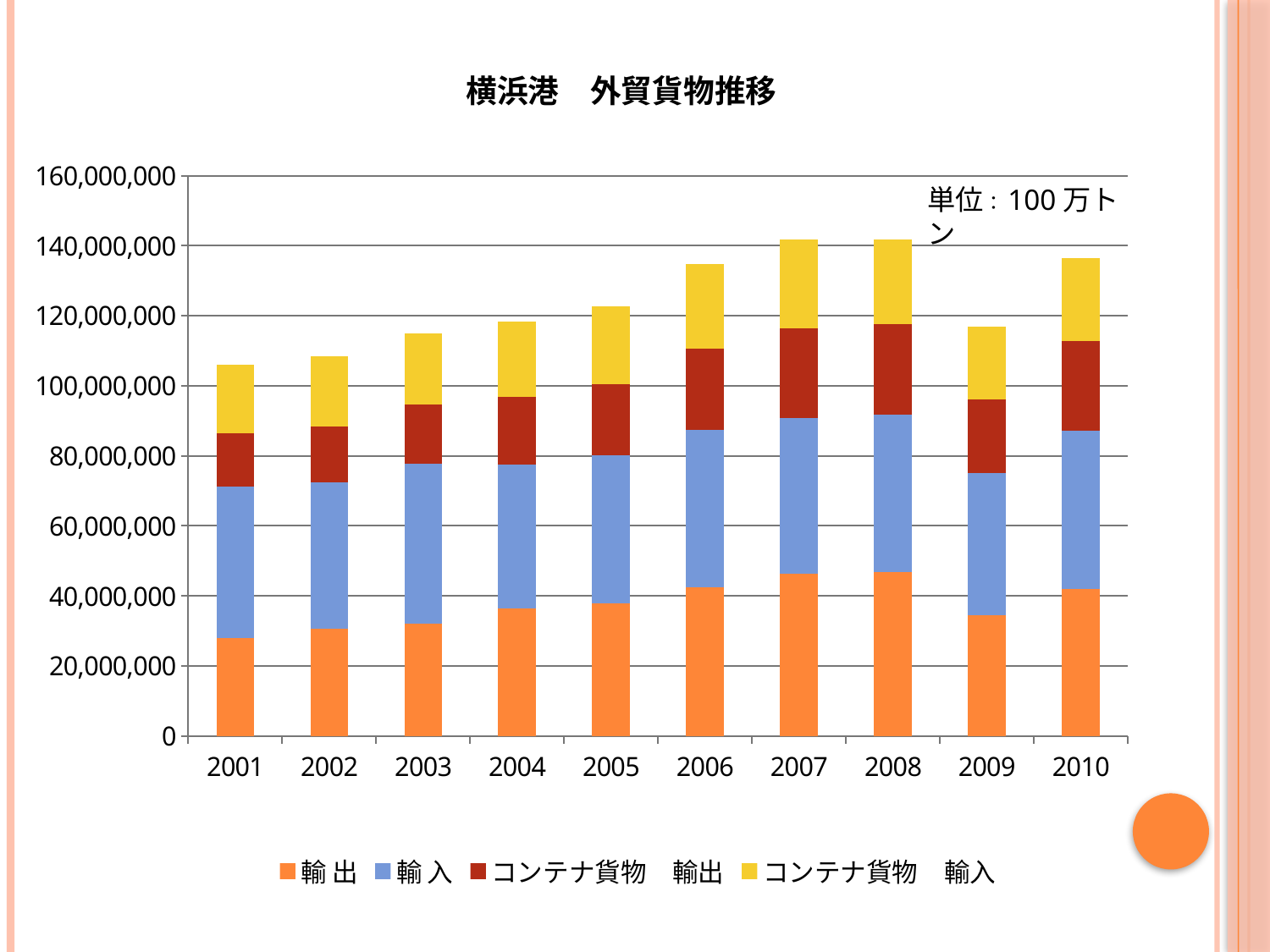
Is the total stacked value for 2001 greater or less than 100,000,000? greater Is the 輸出 value for 2007 greater or less than 40,000,000? greater Is the 輸出 value for 2001 greater or less than 40,000,000? less What is the title of the chart? 横浜港 外貿貨物推移 How many series does the legend list? 4 How many years are shown on the x axis? 10 What kind of chart is shown on the slide? Stacked bar chart Do the total stacked values rise or fall from 2001 to 2008? rise What unit note is printed in the upper right of the chart area? 単位：100万トン Which year has the larger total stacked value, 2006 or 2009? 2006